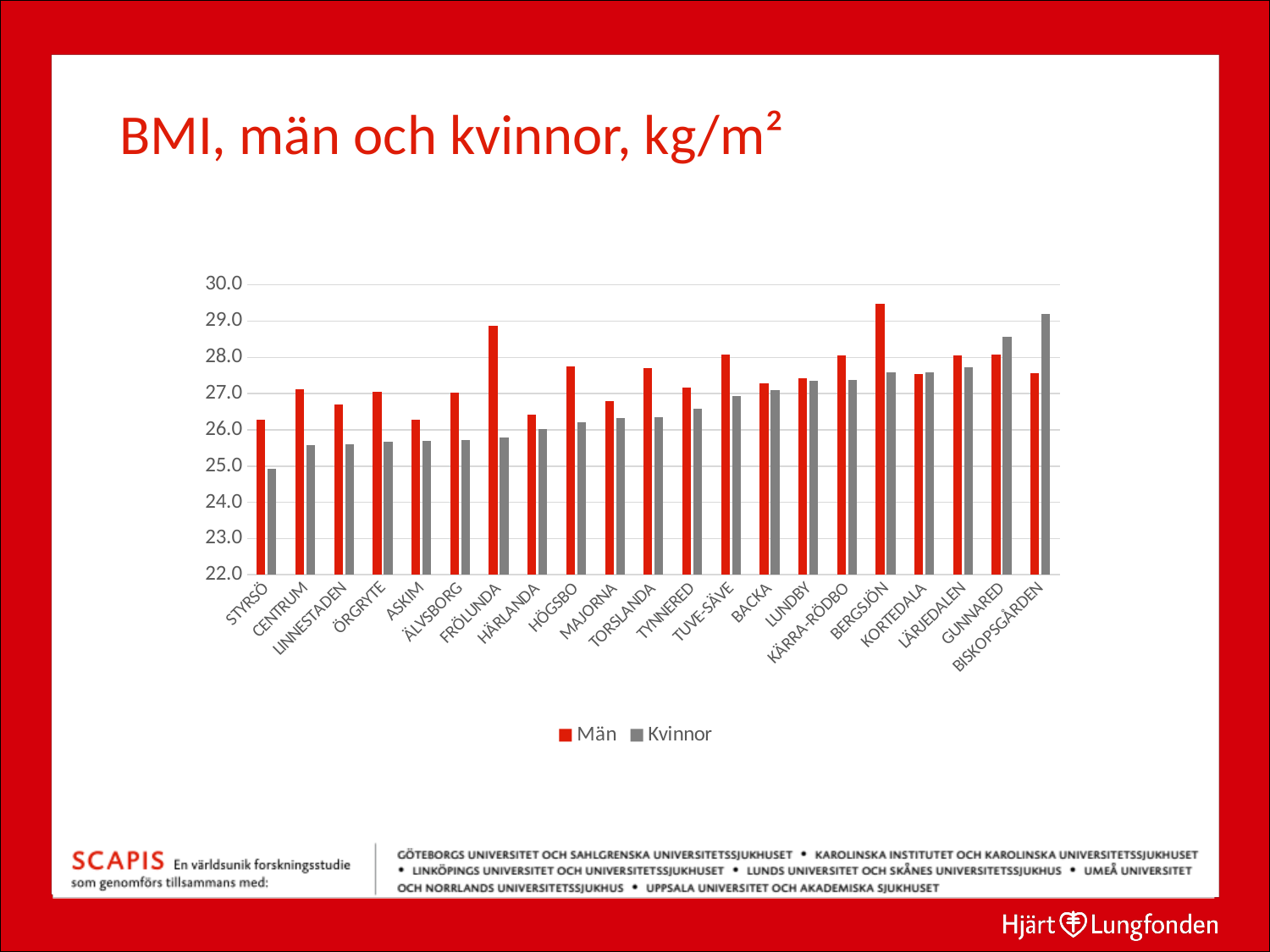
How many series does the legend list? 2 What is the title of the chart? BMI, män och kvinnor, kg/m² How many districts (categories) are shown on the x axis? 21 Which district has the highest BMI value for Män? Bergsjön Which district has the lowest BMI value for Kvinnor? Styrsö Is the Kvinnor value for Gunnared greater or less than 28.0? greater What kind of chart is shown on the slide? bar chart Is the Kvinnor value for Centrum greater or less than 26.0? less For Frölunda, which is larger, the Män value or the Kvinnor value? Män Which district has the highest BMI value for Kvinnor? Biskopsgården For Biskopsgården, which is larger, the Män value or the Kvinnor value? Kvinnor Is the Män value for Frölunda greater or less than 28.0? greater